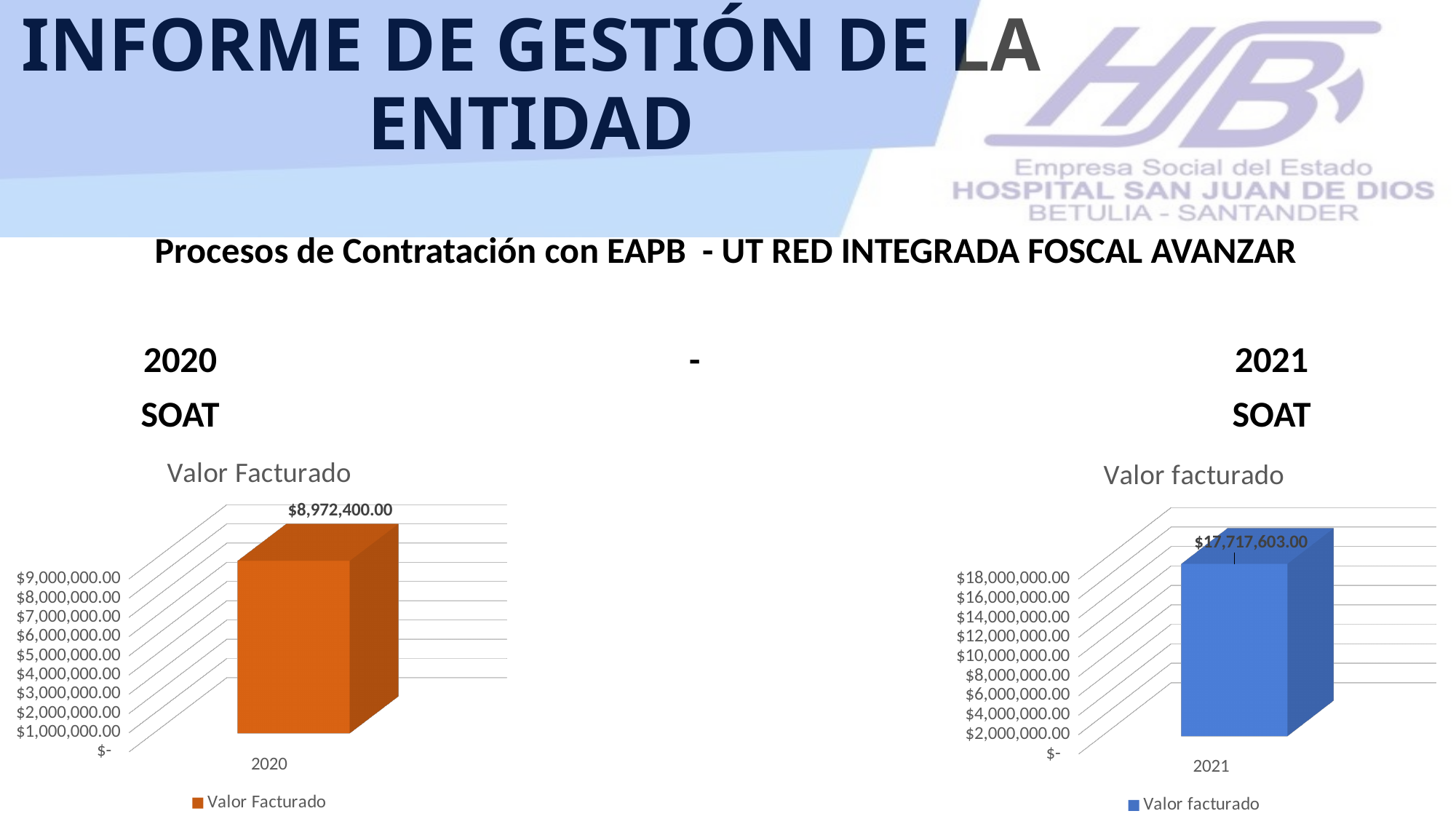
How many series does the legend of the right chart titled 'Valor facturado' list? 1 On the right chart titled 'Valor facturado', is the value for 2021 greater or less than $16,000,000.00? greater How many bars are plotted on the right chart titled 'Valor facturado'? 1 What is the difference between the 2021 value on the right chart and the 2020 value on the left chart? $8,745,203.00 On the left chart titled 'Valor Facturado', is the value for 2020 greater or less than $8,000,000.00? greater What kind of chart is the right chart titled 'Valor facturado'? bar chart Which is larger: the 2020 value on the left chart or the 2021 value on the right chart? 2021 How many bars are plotted on the left chart titled 'Valor Facturado'? 1 How many series does the legend of the left chart titled 'Valor Facturado' list? 1 What kind of chart is the left chart titled 'Valor Facturado'? bar chart On the right chart titled 'Valor facturado', what is the value for 2021? $17,717,603.00 On the left chart titled 'Valor Facturado', what is the value for 2020? $8,972,400.00